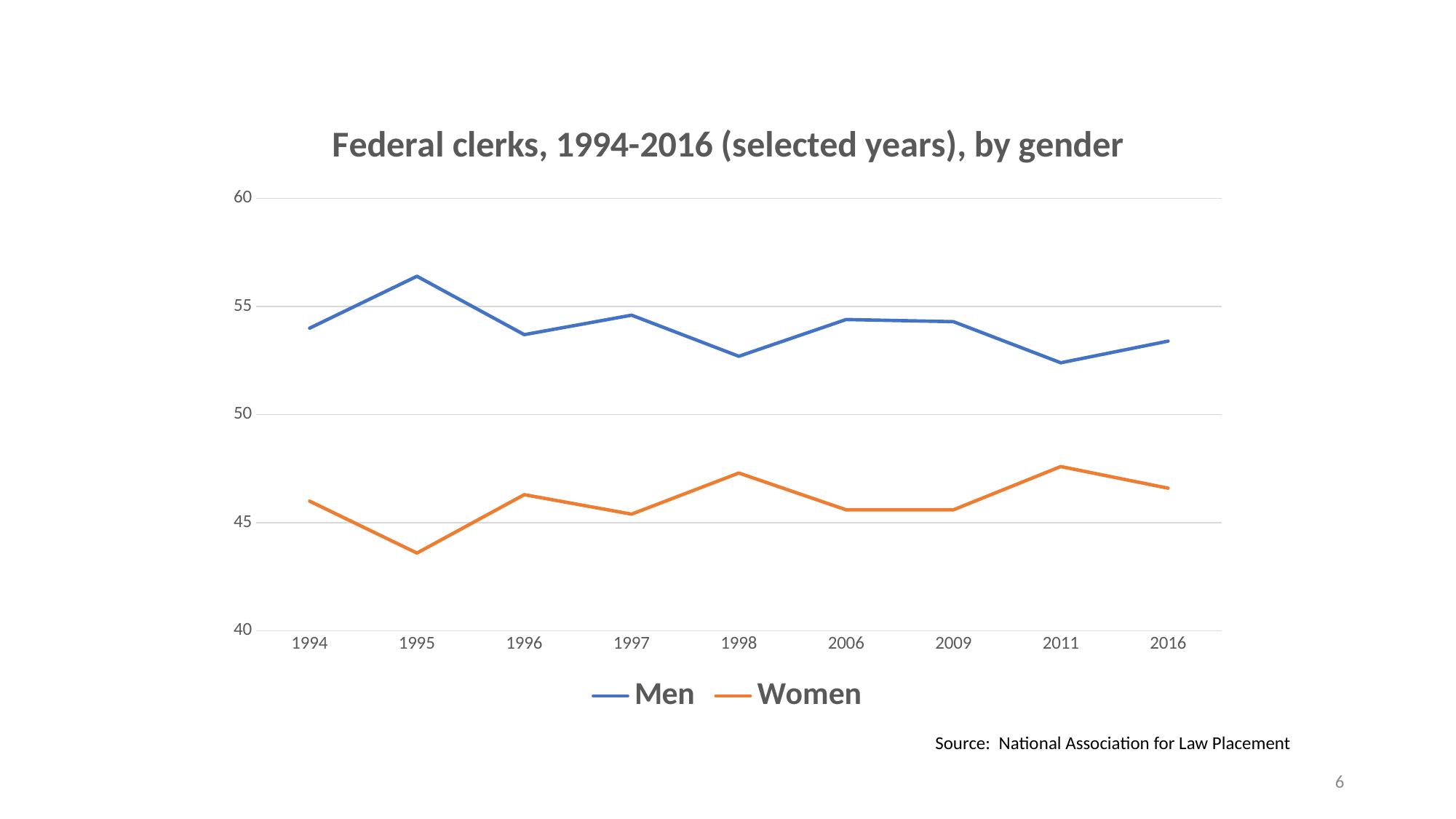
What kind of chart is shown on the slide? line chart In which year is the value for Women lowest? 1995 In which year is the value for Men highest? 1995 How many years are plotted along the x axis? 9 Is the value for Women in 2011 greater or less than 45? greater Is the value for Women in 1995 greater or less than 45? less Is the value for Men in 1995 greater or less than 55? greater Does the Women line rise or fall from 1994 to 1995? fall Which series has the larger value in 1994, Men or Women? Men How many series does the legend list? 2 What is the title of the chart? Federal clerks, 1994-2016 (selected years), by gender